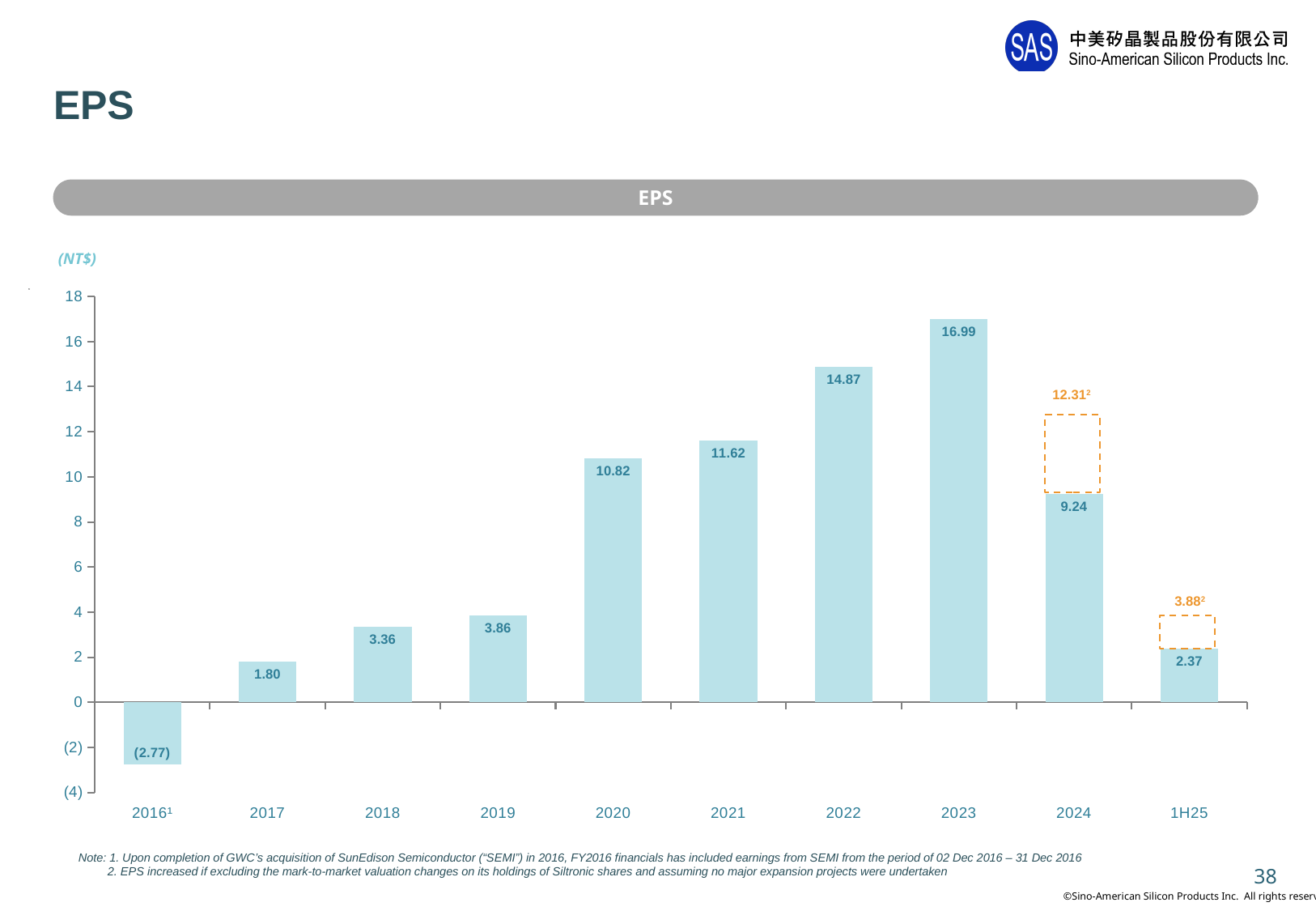
Which period has the lowest EPS? 2016 What is the EPS value for 1H25 (solid bar)? 2.37 What is the EPS value shown for 2016? (2.77) Is the EPS value for 2022 greater or less than 14? greater Which is larger, the EPS for 2021 or the EPS for 2024? 2021 What is the EPS value for 2023? 16.99 What unit is indicated for the EPS values on the chart? NT$ Which year has the highest EPS? 2023 What kind of chart is shown on the slide? Bar chart What is the difference between the EPS for 2023 and the EPS for 2022? 2.12 How many periods are shown on the x axis of the chart? 10 What is the EPS value for 2020? 10.82